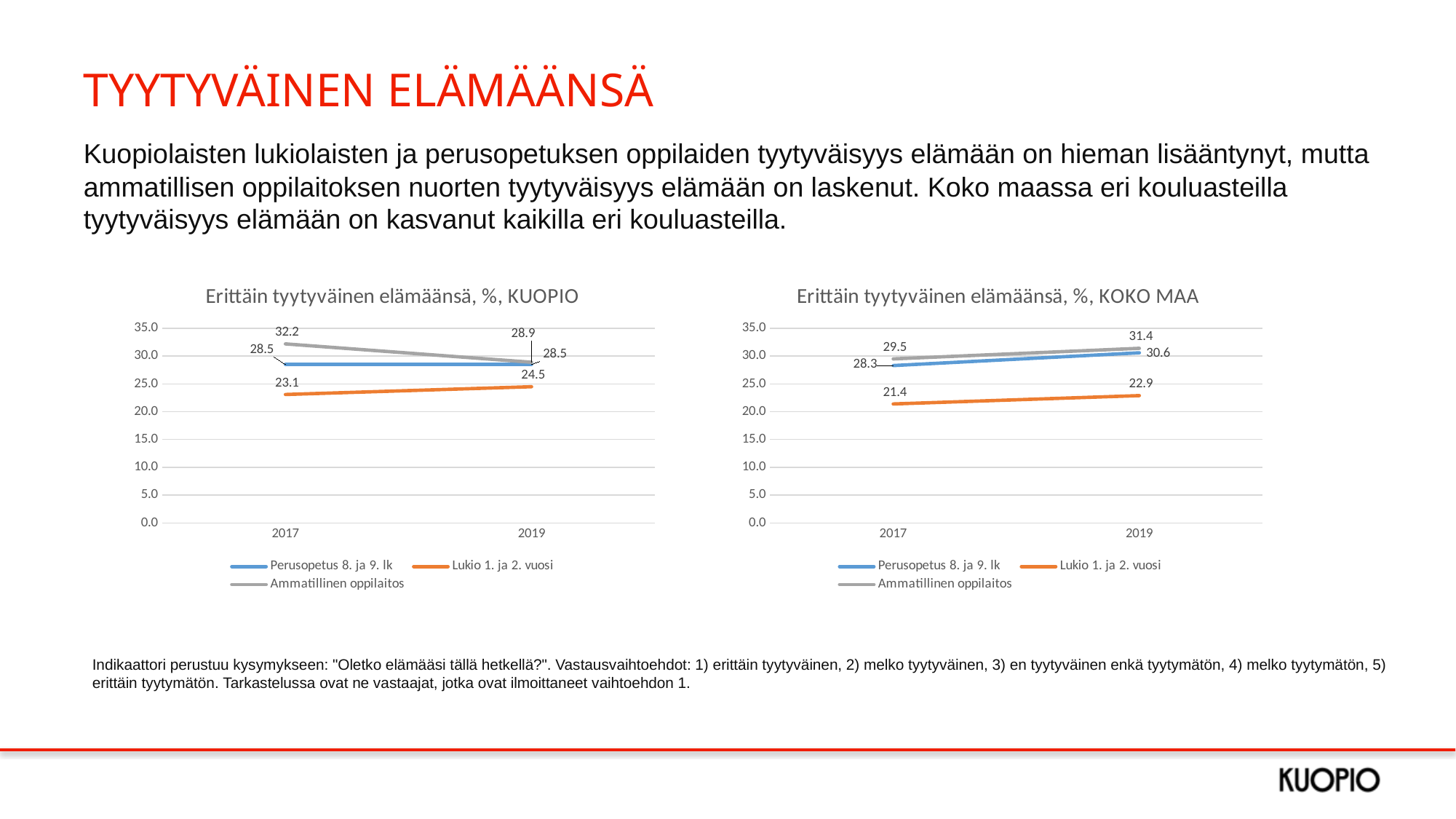
What kind of chart is the chart titled "Erittäin tyytyväinen elämäänsä, %, KOKO MAA"? line chart In the chart titled "Erittäin tyytyväinen elämäänsä, %, KOKO MAA", what is the value for Lukio 1. ja 2. vuosi in 2017? 21.4 In the chart titled "Erittäin tyytyväinen elämäänsä, %, KUOPIO", what is the value for Ammatillinen oppilaitos in 2017? 32.2 In the chart titled "Erittäin tyytyväinen elämäänsä, %, KOKO MAA", does the value for Lukio 1. ja 2. vuosi rise or fall from 2017 to 2019? rise In the chart titled "Erittäin tyytyväinen elämäänsä, %, KOKO MAA", what is the difference between Perusopetus 8. ja 9. lk and Lukio 1. ja 2. vuosi in 2019? 7.7 In the chart titled "Erittäin tyytyväinen elämäänsä, %, KOKO MAA", what is the value for Perusopetus 8. ja 9. lk in 2019? 30.6 How many series does the legend of the chart titled "Erittäin tyytyväinen elämäänsä, %, KUOPIO" list? 3 In the chart titled "Erittäin tyytyväinen elämäänsä, %, KUOPIO", by how much did the value for Ammatillinen oppilaitos change from 2017 to 2019? 3.3 In the chart titled "Erittäin tyytyväinen elämäänsä, %, KUOPIO", does the value for Ammatillinen oppilaitos rise or fall from 2017 to 2019? fall In the chart titled "Erittäin tyytyväinen elämäänsä, %, KOKO MAA", which series has the highest value in 2019? Ammatillinen oppilaitos In the chart titled "Erittäin tyytyväinen elämäänsä, %, KUOPIO", which series has the lowest value in 2017? Lukio 1. ja 2. vuosi In the chart titled "Erittäin tyytyväinen elämäänsä, %, KUOPIO", what is the value for Lukio 1. ja 2. vuosi in 2019? 24.5